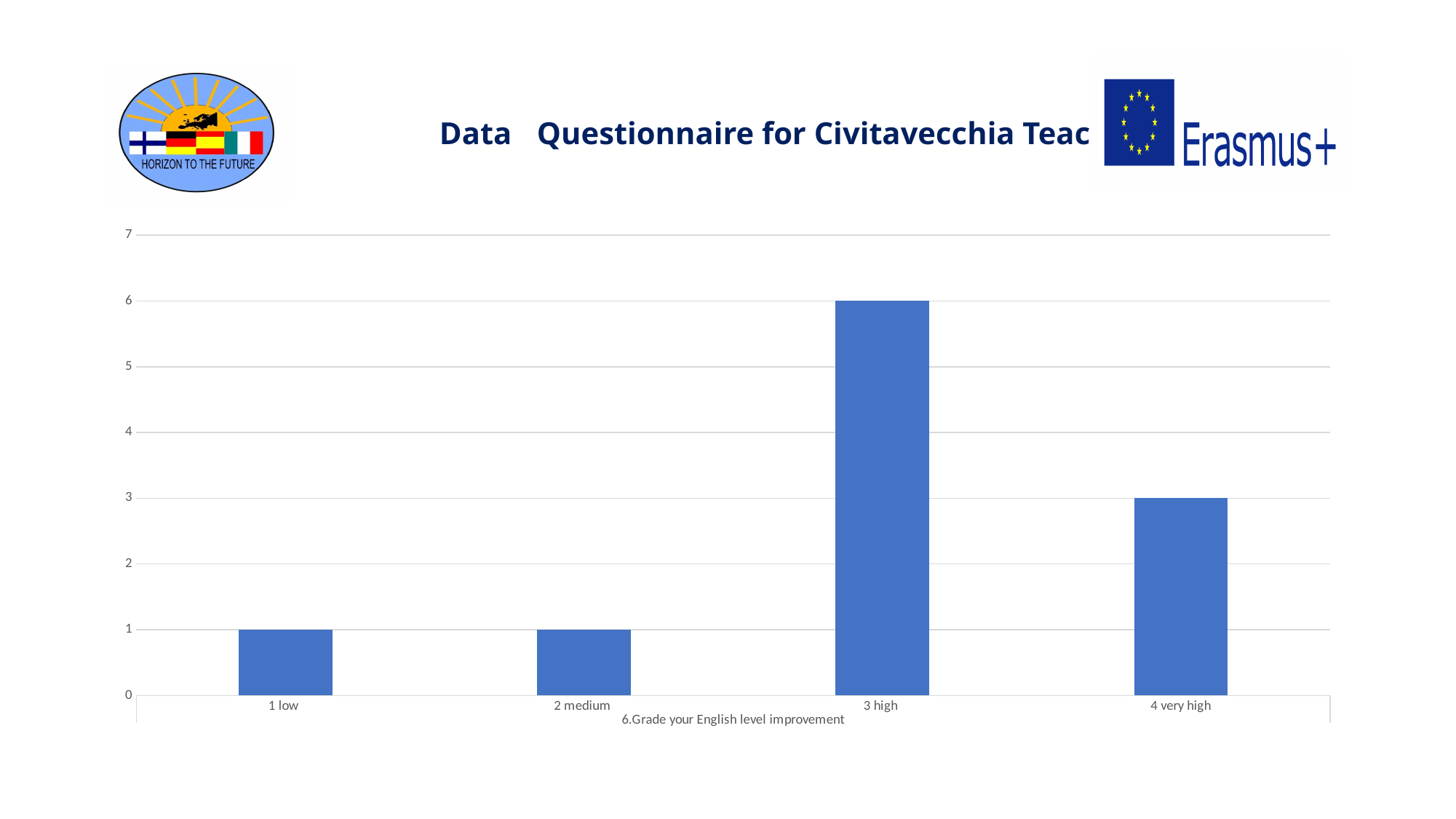
What is the total of the values for "1 low" and "2 medium"? 2 What kind of chart is shown on the slide? bar chart Is the value for "3 high" greater or less than 5? greater What is the value for "3 high"? 6 Which is larger, the value for "4 very high" or the value for "2 medium"? 4 very high What is the value for "4 very high"? 3 What is the value for "1 low"? 1 What is the x-axis title of the chart? 6.Grade your English level improvement How many categories are shown on the x axis? 4 What is the difference between the values for "3 high" and "4 very high"? 3 What is the highest value shown on the vertical axis? 7 Which category has the highest value? 3 high